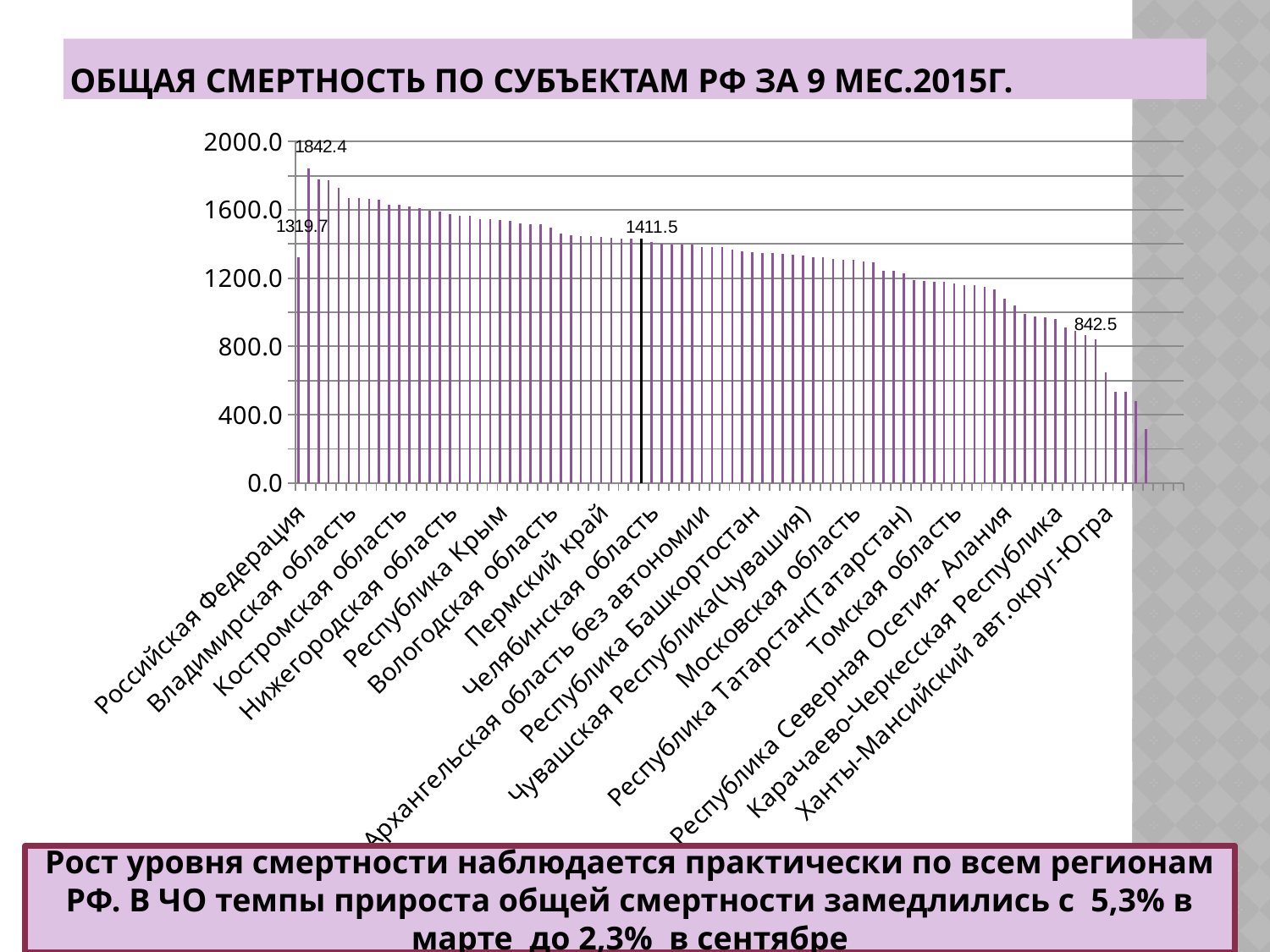
What is the difference between the values for Челябинская область and Российская Федерация? 91.8 What is the title of the slide's chart? ОБЩАЯ СМЕРТНОСТЬ ПО СУБЪЕКТАМ РФ ЗА 9 МЕС.2015Г. What is the highest value labelled on the chart? 1842.4 Is the value for Ханты-Мансийский авт.округ-Югра greater or less than 800? less Is the value for Московская область greater or less than 1200? greater Do the bar values generally rise or fall from left to right after the first bar? fall Is the value for Республика Северная Осетия-Алания greater or less than 1600? less What is the value for Челябинская область? 1411.5 Which is larger, the value for Челябинская область or the value for Российская Федерация? Челябинская область What kind of chart is shown on the slide? bar chart What is the value for Российская Федерация? 1319.7